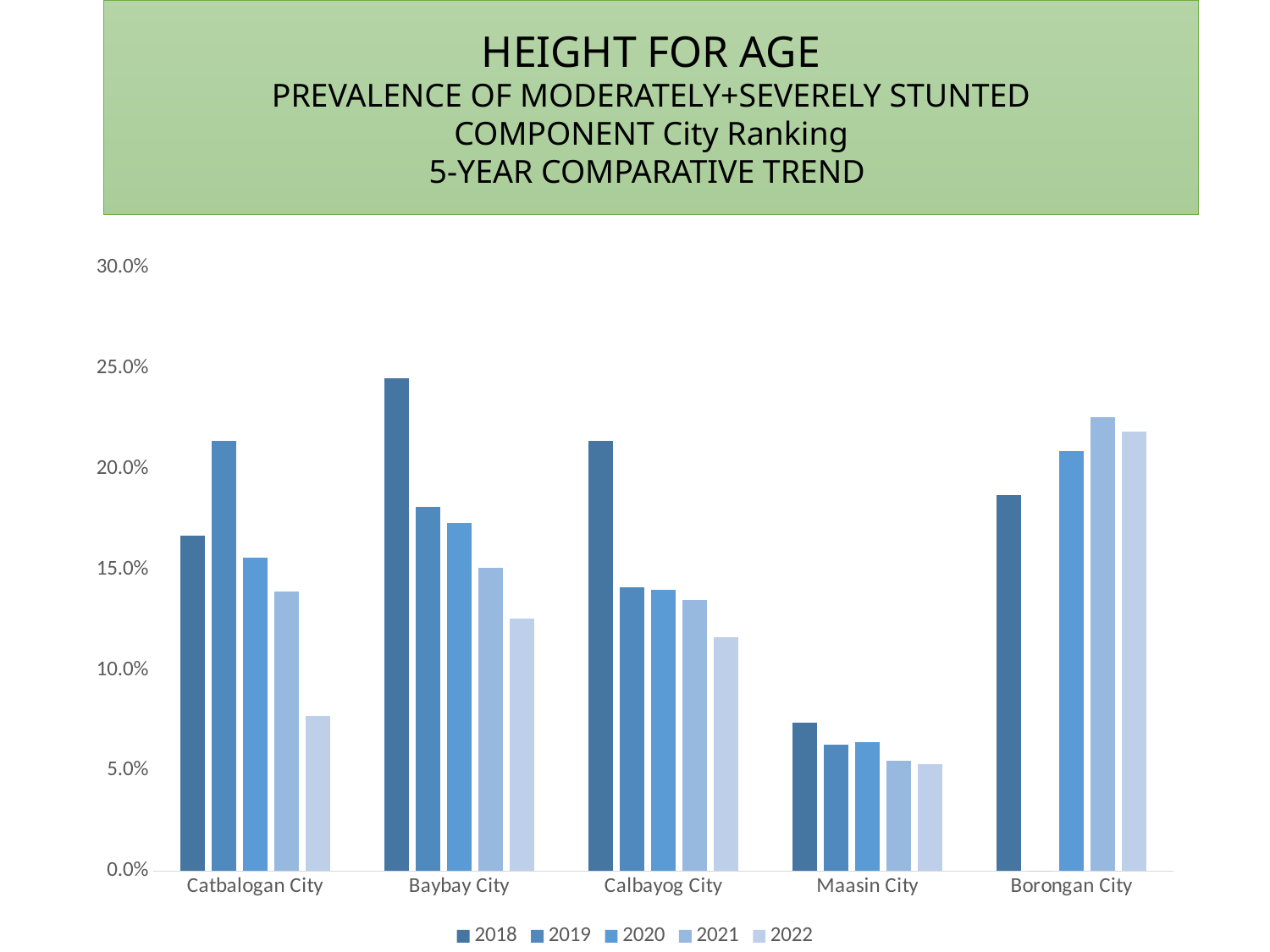
Is the 2018 value for Baybay City greater or less than 20.0%? greater Which city has the lowest value for 2018? Maasin City What kind of chart is shown on the slide? bar chart Which city has the highest value for 2020? Borongan City What is the first entry in the legend? 2018 For Catbalogan City, which is larger: the 2018 value or the 2019 value? 2019 How many series does the legend list? 5 Which city has the highest value for 2018? Baybay City Do the values for Baybay City rise or fall from 2018 to 2022? fall Is the 2022 value for Catbalogan City greater or less than 10.0%? less Is the 2018 value for Maasin City greater or less than 10.0%? less How many cities are shown on the x axis? 5